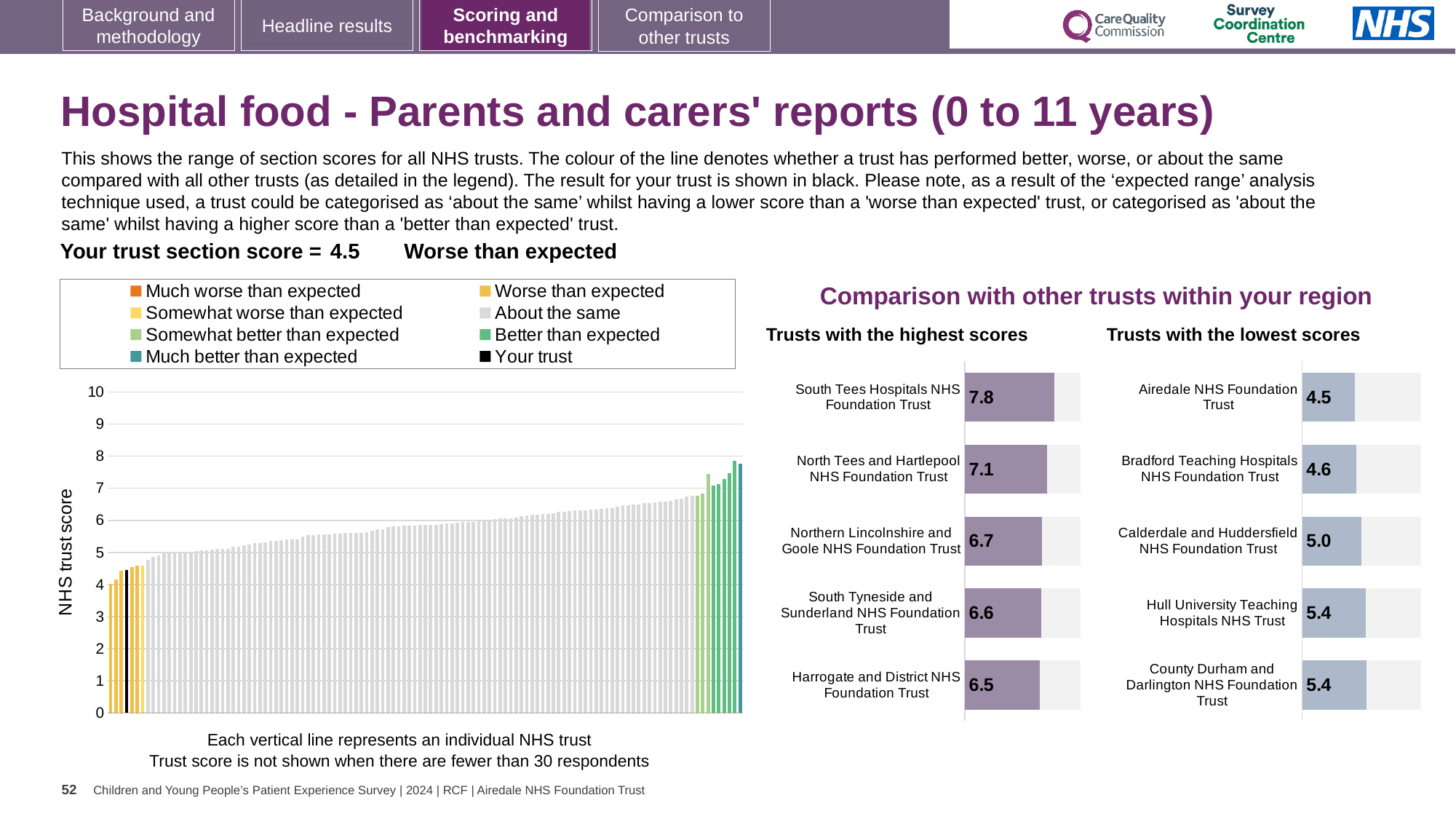
In the 'Trusts with the highest scores' chart, what is the difference between the scores of South Tees Hospitals NHS Foundation Trust and North Tees and Hartlepool NHS Foundation Trust? 0.7 In the 'Trusts with the lowest scores' chart, which has the higher score: Calderdale and Huddersfield NHS Foundation Trust or Airedale NHS Foundation Trust? Calderdale and Huddersfield NHS Foundation Trust How many trusts are shown in the 'Trusts with the lowest scores' chart? 5 In the 'Trusts with the highest scores' chart, what is the score for South Tees Hospitals NHS Foundation Trust? 7.8 In the 'Trusts with the highest scores' chart, what is the score for Harrogate and District NHS Foundation Trust? 6.5 In the 'Trusts with the lowest scores' chart, what is the score for Bradford Teaching Hospitals NHS Foundation Trust? 4.6 In the main chart of all NHS trusts on the left, what is the section score for your trust (the black bar)? 4.5 In the main chart of all NHS trusts on the left, is the value of the tallest bar greater or less than 7? greater What type of chart is the main chart of all NHS trusts on the left? Bar chart How many entries does the legend of the main chart on the left list? 8 In the 'Trusts with the lowest scores' chart, which trust has the lowest score? Airedale NHS Foundation Trust In the 'Trusts with the highest scores' chart, which trust has the highest score? South Tees Hospitals NHS Foundation Trust